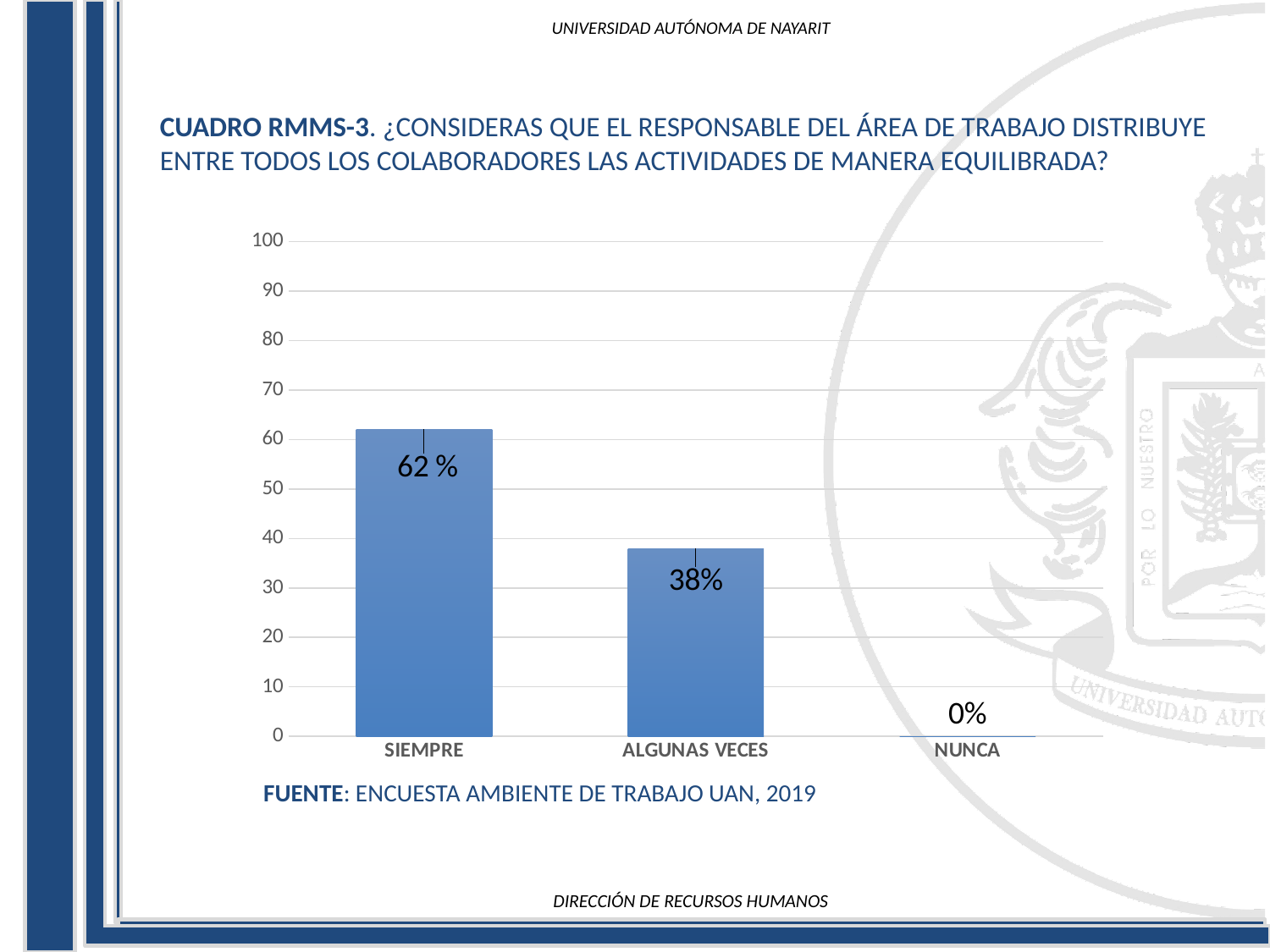
Is the value for SIEMPRE greater or less than 60? greater What is the value for SIEMPRE? 62 % Which category has the lowest value? NUNCA What is the value for NUNCA? 0% What is the difference between the values for SIEMPRE and ALGUNAS VECES? 24% Is the value for ALGUNAS VECES greater or less than 40? less Do the values rise or fall from left to right along the x axis? fall Which category has the highest value? SIEMPRE What kind of chart is shown on the slide? bar chart What is the value for ALGUNAS VECES? 38% Which is larger, the value for SIEMPRE or the value for ALGUNAS VECES? SIEMPRE How many categories are shown on the x axis? 3